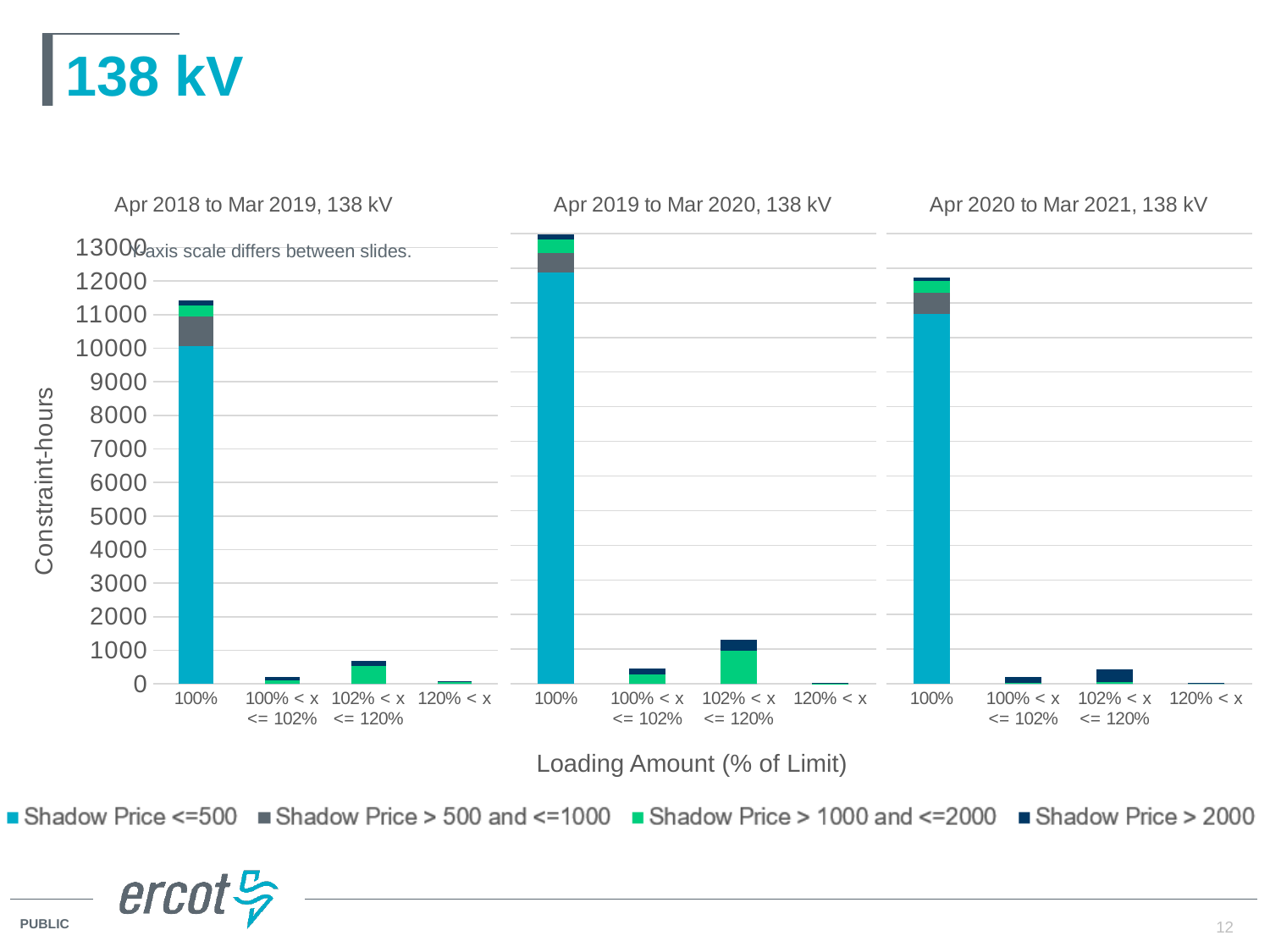
What is the label on the shared y axis of the charts? Constraint-hours In the Apr 2018 to Mar 2019, 138 kV chart, is the total for the 100% category greater or less than 10000? greater In the Apr 2019 to Mar 2020, 138 kV chart, is the total for the 102% < x <= 120% category greater or less than 1000? greater What is the title of the middle chart? Apr 2019 to Mar 2020, 138 kV In the Apr 2019 to Mar 2020, 138 kV chart, which loading amount category has the highest total constraint-hours? 100% In the Apr 2020 to Mar 2021, 138 kV chart, which loading amount category has the lowest total constraint-hours? 120% < x In the Apr 2018 to Mar 2019, 138 kV chart, how many loading amount categories are shown on the x axis? 4 In the Apr 2018 to Mar 2019, 138 kV chart, is the total for the 102% < x <= 120% category greater or less than 1000? less What kind of chart is shown on the slide? Stacked bar chart How many series does the legend list? 4 In the Apr 2020 to Mar 2021, 138 kV chart, which is larger: the total for 100% < x <= 102% or the total for 102% < x <= 120%? 102% < x <= 120%